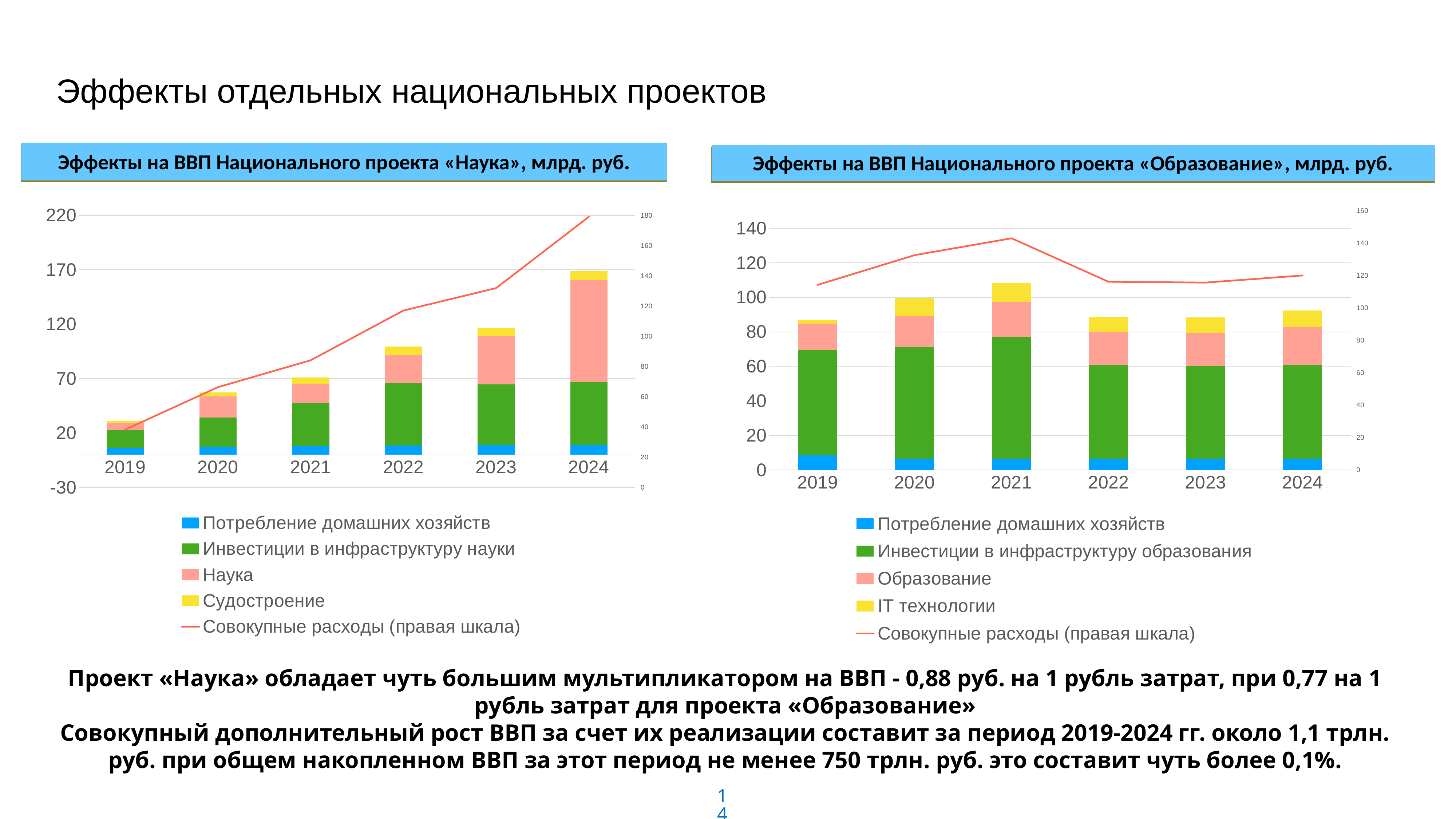
In the left chart («Наука»), how many series does the legend list? 5 In the right chart («Образование»), which series is shown in yellow according to the legend? IT технологии What kind of chart is the left chart, «Эффекты на ВВП Национального проекта «Наука»»? Stacked bar chart with a line In the left chart («Наука»), which year has the highest total stacked bar? 2024 In the right chart («Образование»), which is larger: the total stacked bar for 2021 or for 2019? 2021 In the left chart («Наука»), do the total stacked bars rise or fall from 2019 to 2024? rise In the right chart («Образование»), in which year does the line «Совокупные расходы (правая шкала)» reach its peak? 2021 In the left chart («Наука»), which year has the lowest total stacked bar? 2019 In the left chart («Наука»), how many years are shown on the x axis? 6 In the right chart («Образование»), which year has the highest total stacked bar? 2021 In the right chart («Образование»), is the total stacked bar for 2021 greater or less than 100? greater In the left chart («Наука»), is the total stacked bar for 2024 greater or less than 120? greater